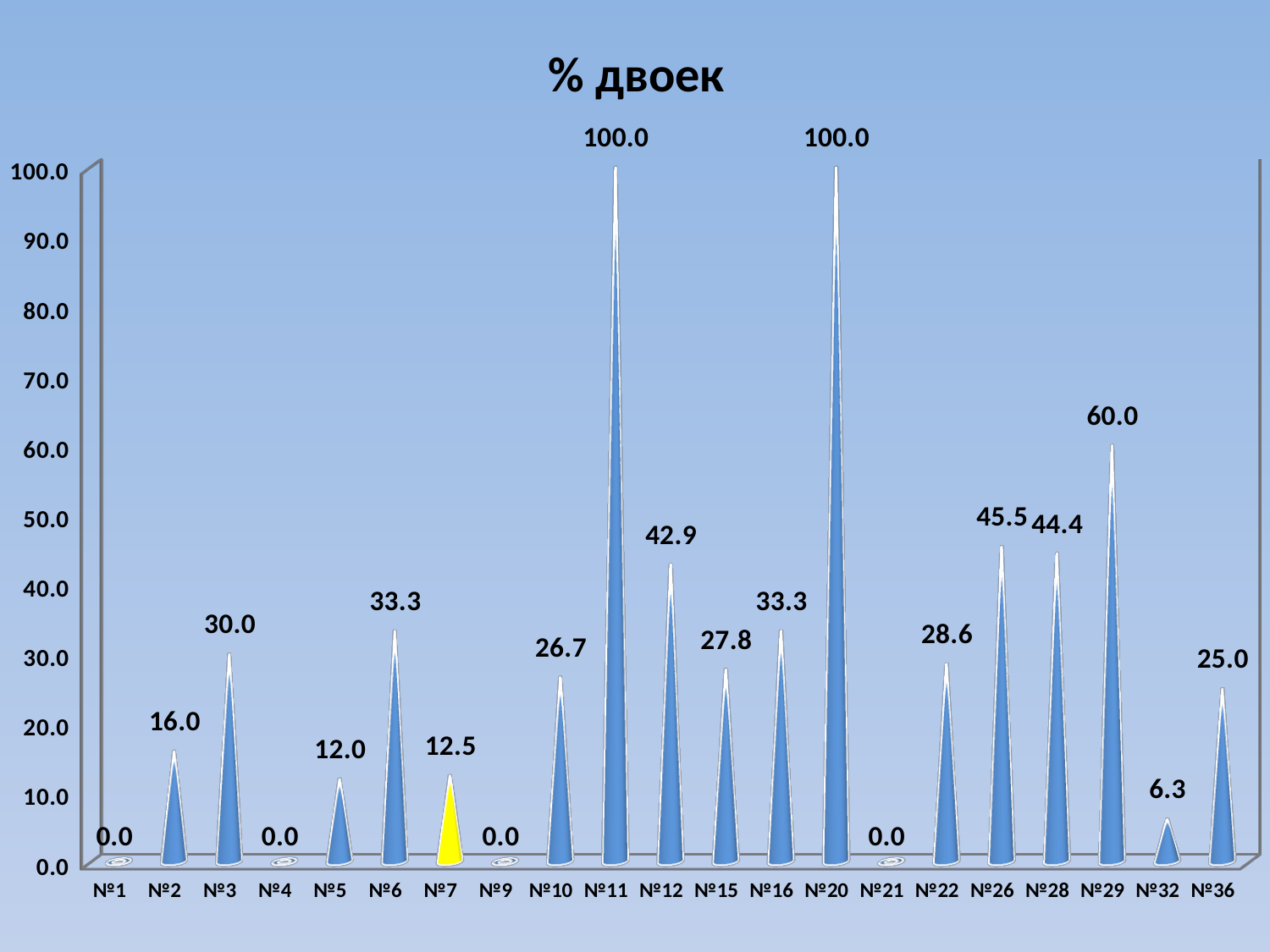
What is the value for №12 in the chart? 42.9 Which has a larger value, №10 or №15? №15 What kind of chart is shown on the slide? bar chart What is the difference between the values for №29 and №36? 35.0 Which category's bar is coloured yellow instead of blue? №7 What is the value for №32 in the chart? 6.3 Which has a larger value, №3 or №22? №3 How many categories are shown on the x axis? 21 What is the title of the chart? % двоек What is the value for №29 in the chart? 60.0 What is the value for №7, the yellow bar? 12.5 What is the difference between the values for №26 and №28? 1.1